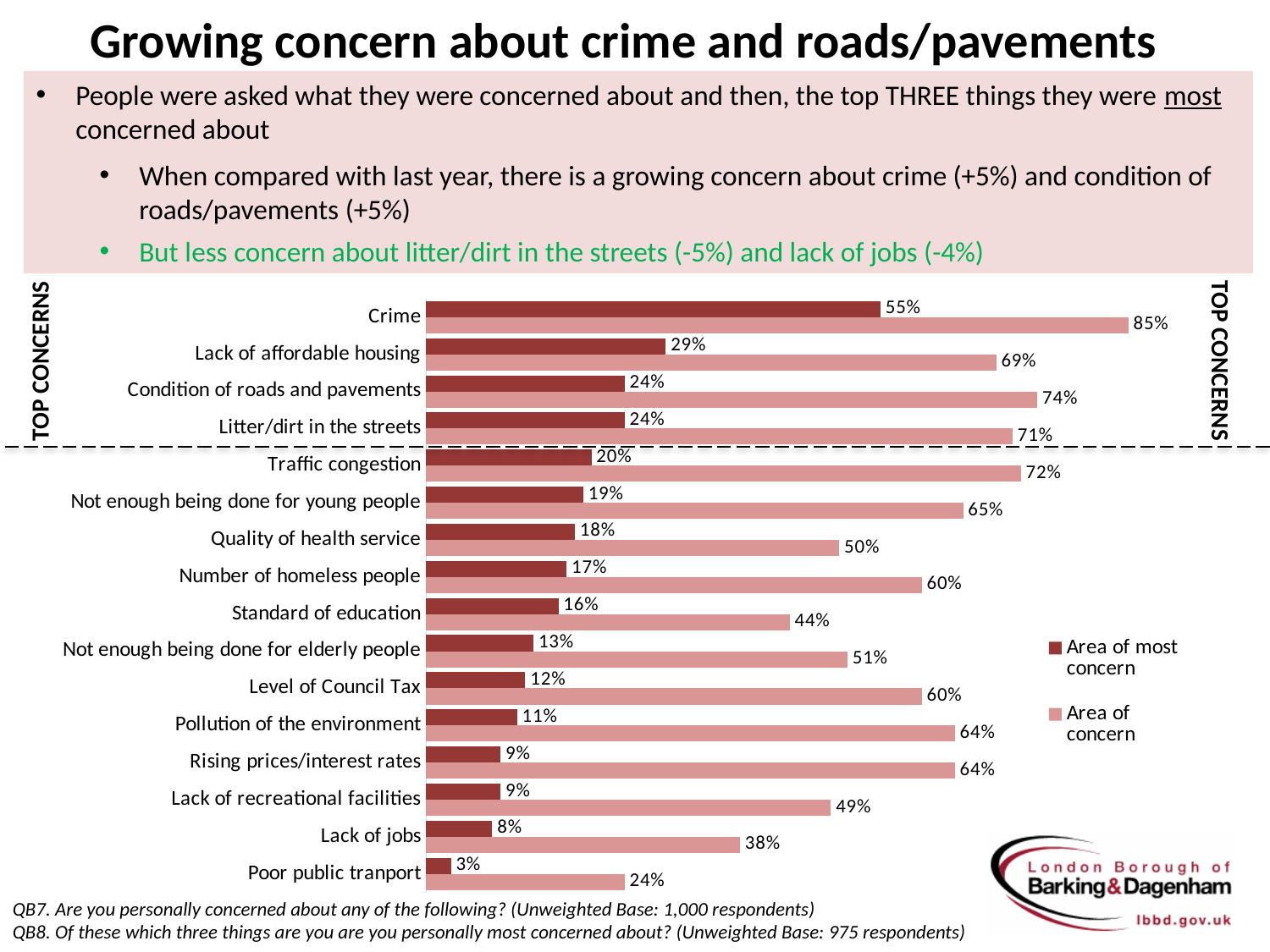
What is the difference between the 'Area of concern' and 'Area of most concern' values for Crime? 30% Which category has the lowest 'Area of most concern' value? Poor public tranport How many series does the legend list? 2 What is the 'Area of concern' value for Condition of roads and pavements? 74% Which series is shown in the darker red colour? Area of most concern What kind of chart is shown on the slide? Bar chart What is the 'Area of concern' value for Standard of education? 44% How many categories are shown in the chart? 16 What is the 'Area of most concern' value for Lack of jobs? 8% What percentage of respondents named Crime as an area of most concern? 55% Which category has the highest 'Area of concern' value? Crime Which has a higher 'Area of concern' value: Traffic congestion or Lack of affordable housing? Traffic congestion